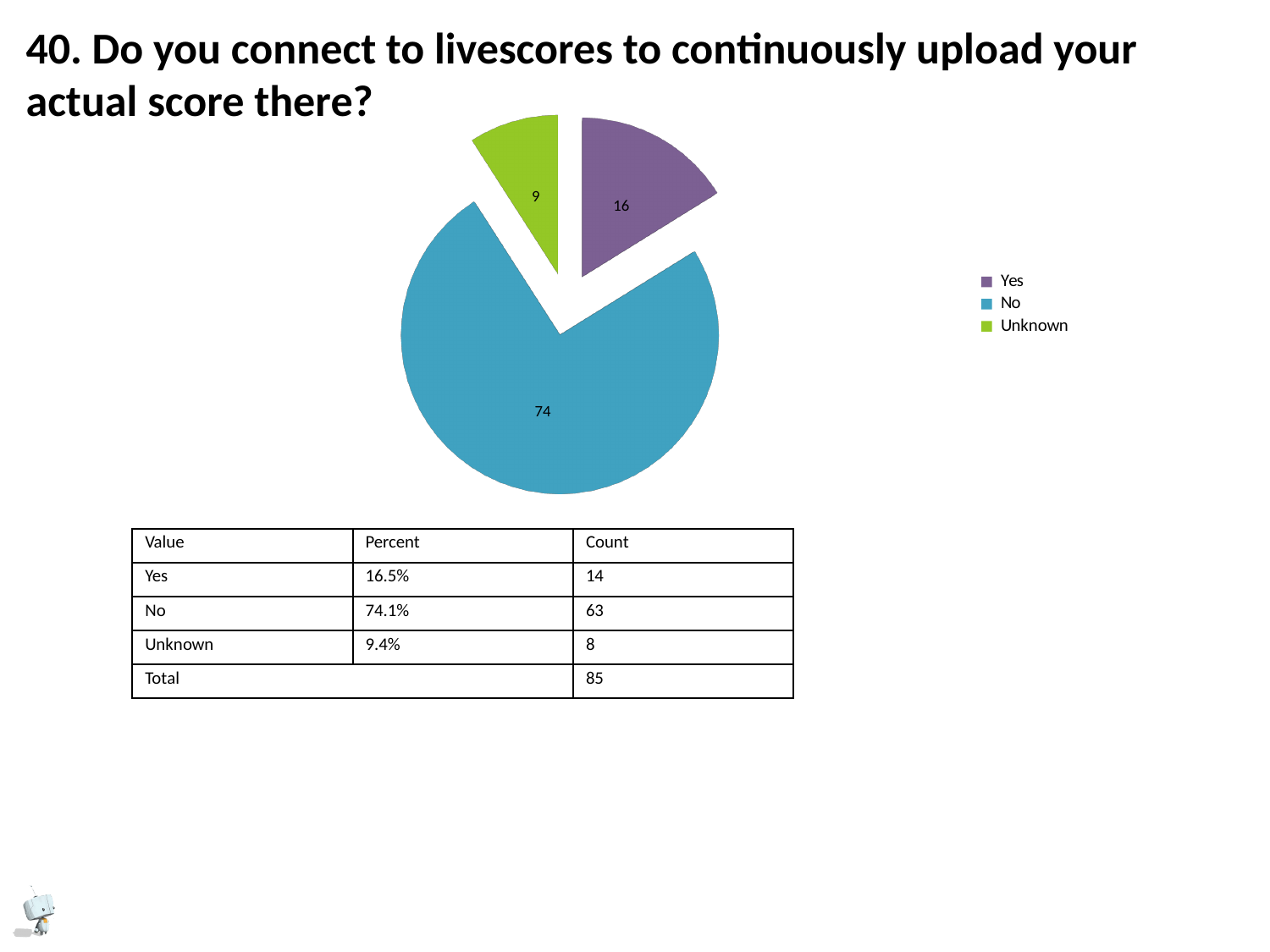
What data label is shown on the Yes slice of the pie chart? 16 What colour is the No slice in the pie chart? blue Which slice is larger, Yes or Unknown? Yes What is the difference between the data labels of the Yes slice and the Unknown slice? 7 How many slices does the pie chart have? 3 What is the difference between the data labels of the No slice and the Yes slice? 58 What data label is shown on the Unknown slice of the pie chart? 9 Which category has the largest slice in the pie chart? No Which category has the smallest slice in the pie chart? Unknown What kind of chart is shown on the slide? pie chart What data label is shown on the No slice of the pie chart? 74 How many entries does the legend list? 3